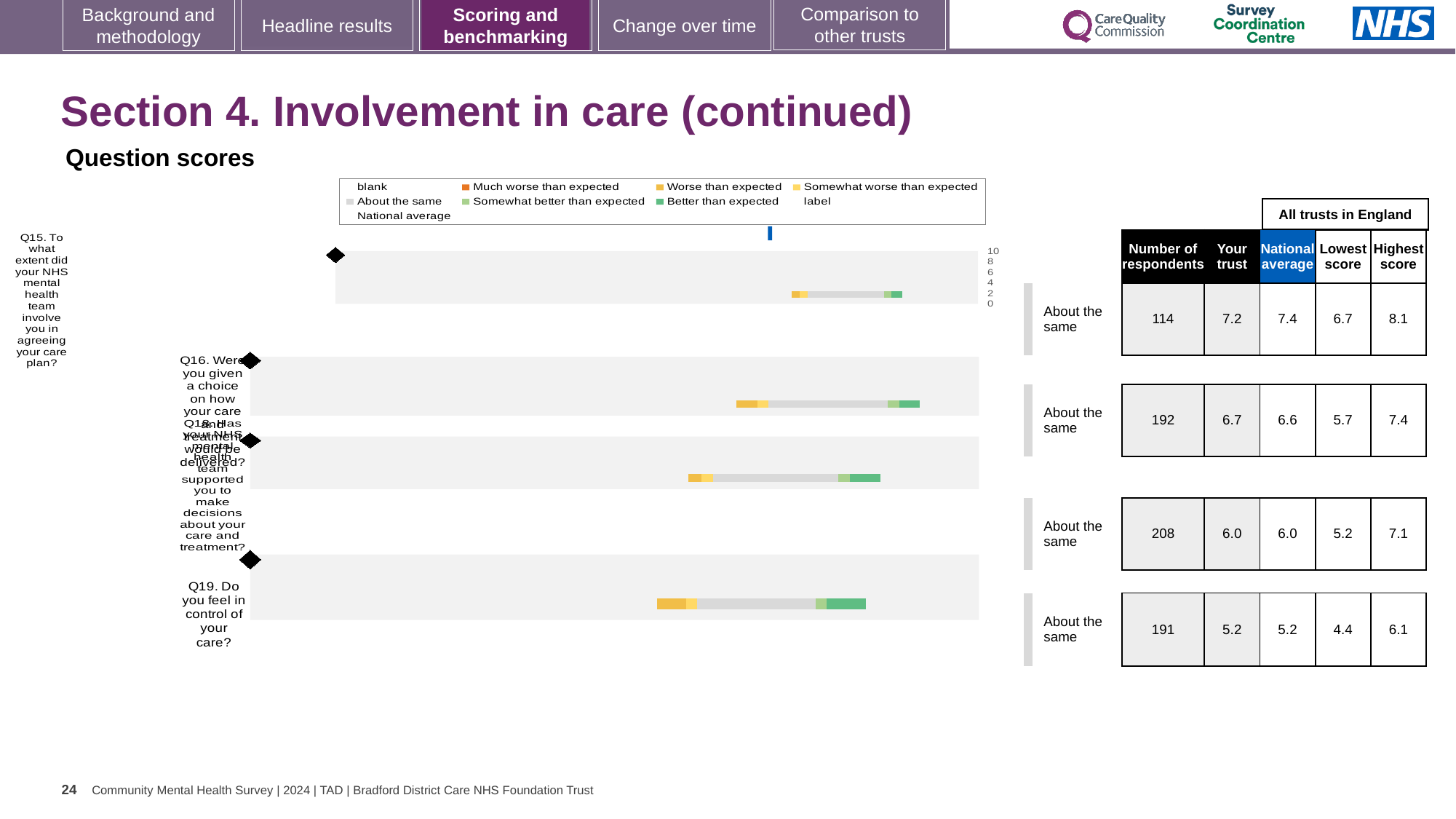
Which question has the lowest 'Your trust' score? Q19 What is the highest score among all trusts in England for Q19 (feeling in control of your care)? 6.1 What is the national average score for Q16 (choice on how care and treatment would be delivered)? 6.6 How many entries does the legend of the question scores chart list? 9 What is the 'Your trust' score for Q15 (involvement in agreeing your care plan)? 7.2 How many questions (categories) are plotted in the question scores chart? 4 What benchmark category is shown next to each question's bar in the chart? About the same For Q15, which is larger: the 'Your trust' score or the national average? National average Which question has the largest number of respondents? Q18 What kind of chart is used to show the question scores on this slide? bar chart For Q15, what is the difference between the highest score (8.1) and the lowest score (6.7) across all trusts in England? 1.4 How many respondents answered Q18 (supported to make decisions about care and treatment)? 208